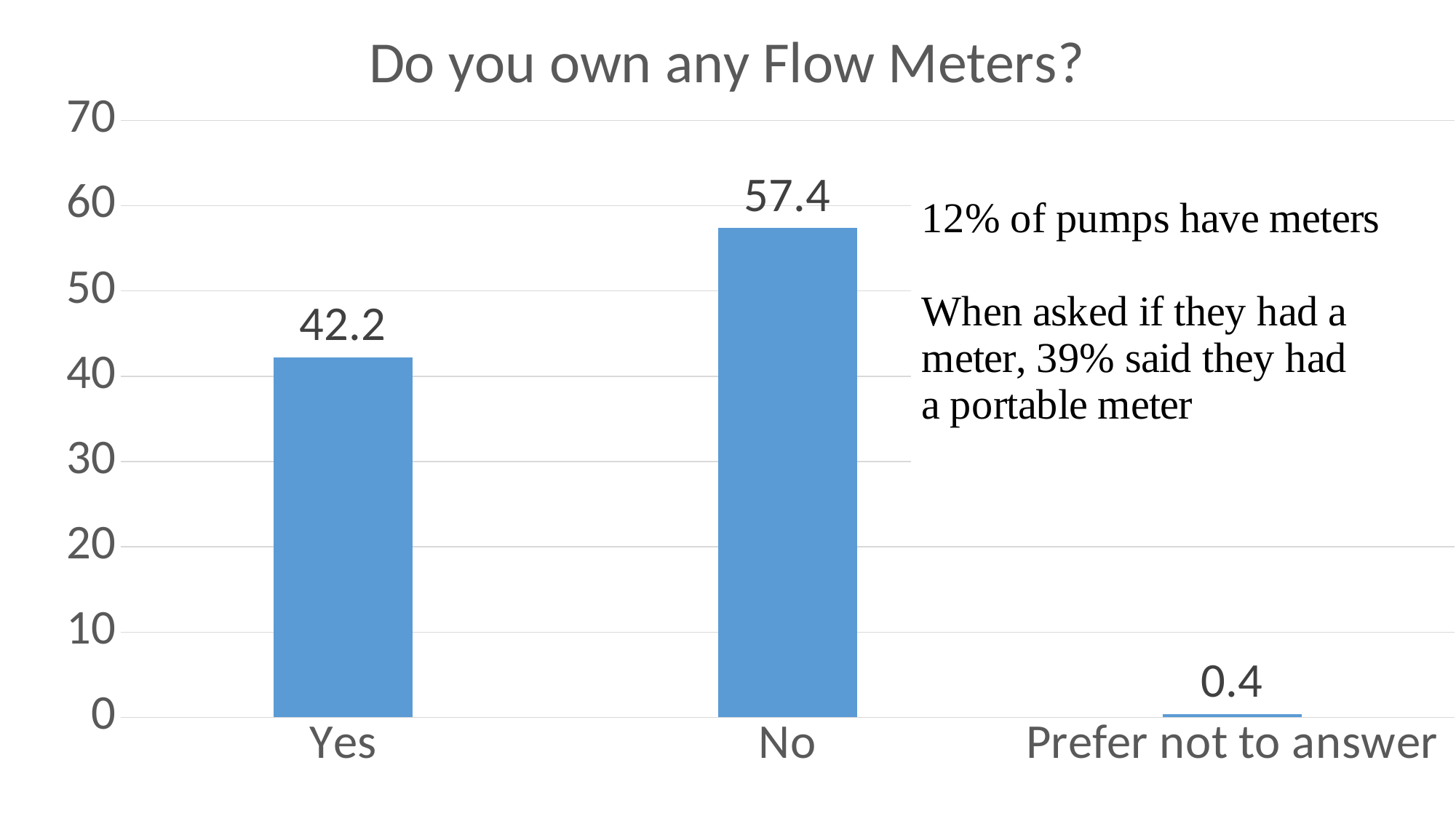
How many categories are shown on the x axis? 3 What kind of chart is shown on the slide? bar chart What is the title of the chart? Do you own any Flow Meters? Which category has the lowest value? Prefer not to answer What is the value for "No"? 57.4 Which category has the highest value? No Is the value for "No" greater or less than 50? greater Which is larger, the value for "Yes" or the value for "No"? No What is the value for "Yes"? 42.2 Is the value for "Yes" greater or less than 50? less What is the value for "Prefer not to answer"? 0.4 What is the difference between the values for "No" and "Yes"? 15.2